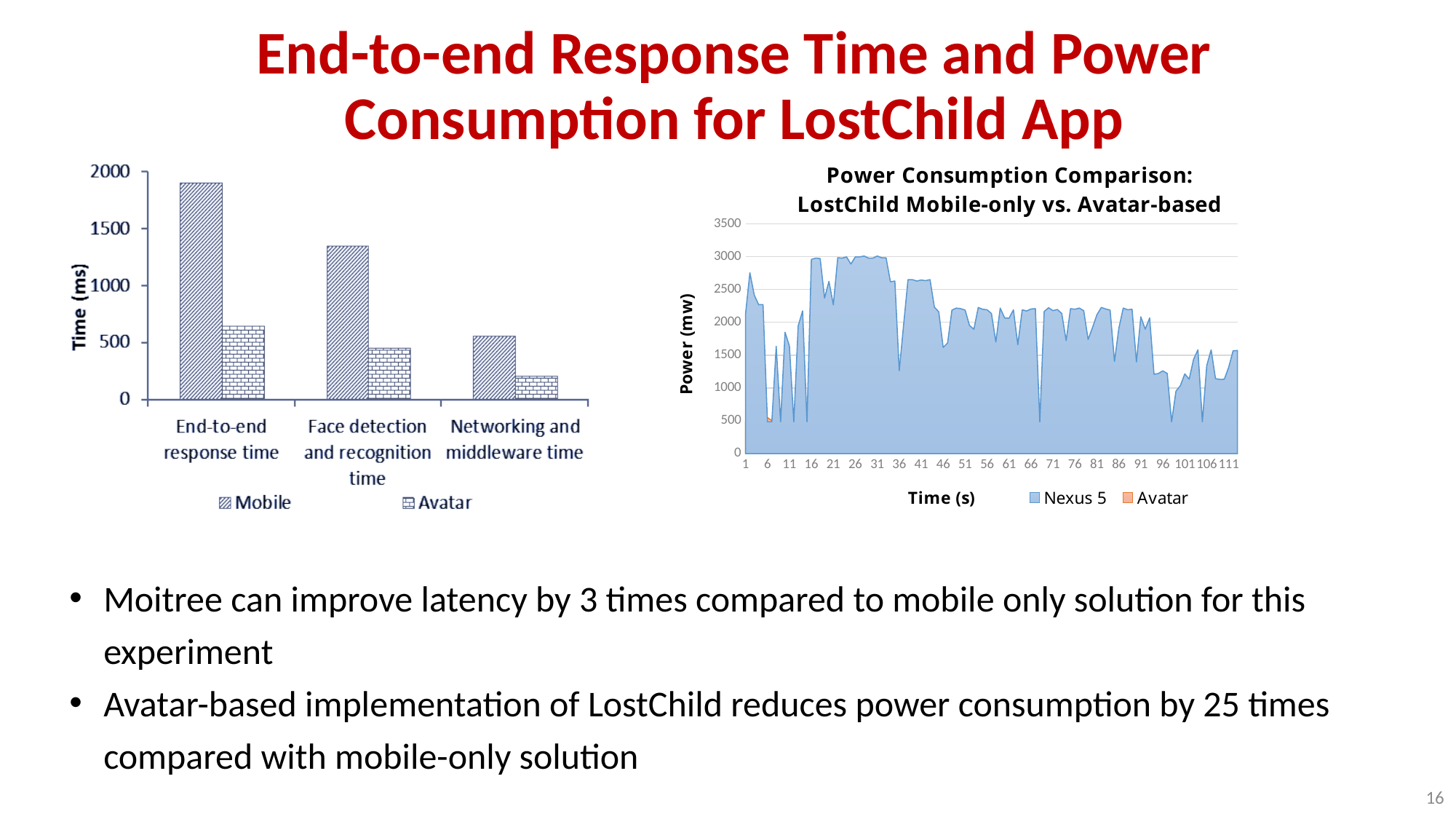
What kind of chart is the one on the left of the slide? bar chart In the chart titled 'Power Consumption Comparison: LostChild Mobile-only vs. Avatar-based', how many series does the legend list? 2 In the bar chart on the left, which category has the highest Mobile value? End-to-end response time In the bar chart on the left, what is the label of the y axis? Time (ms) In the bar chart on the left, is the Mobile value for End-to-end response time greater or less than 1500? greater In the bar chart on the left, which series has the taller bar for End-to-end response time, Mobile or Avatar? Mobile In the chart titled 'Power Consumption Comparison: LostChild Mobile-only vs. Avatar-based', what are the two series named in the legend? Nexus 5 and Avatar In the bar chart on the left, how many categories are shown on the x axis? 3 In the bar chart on the left, how many series does the legend list? 2 In the bar chart on the left, which category has the lowest Avatar value? Networking and middleware time In the bar chart on the left, is the Mobile value for Networking and middleware time greater or less than 1000? less